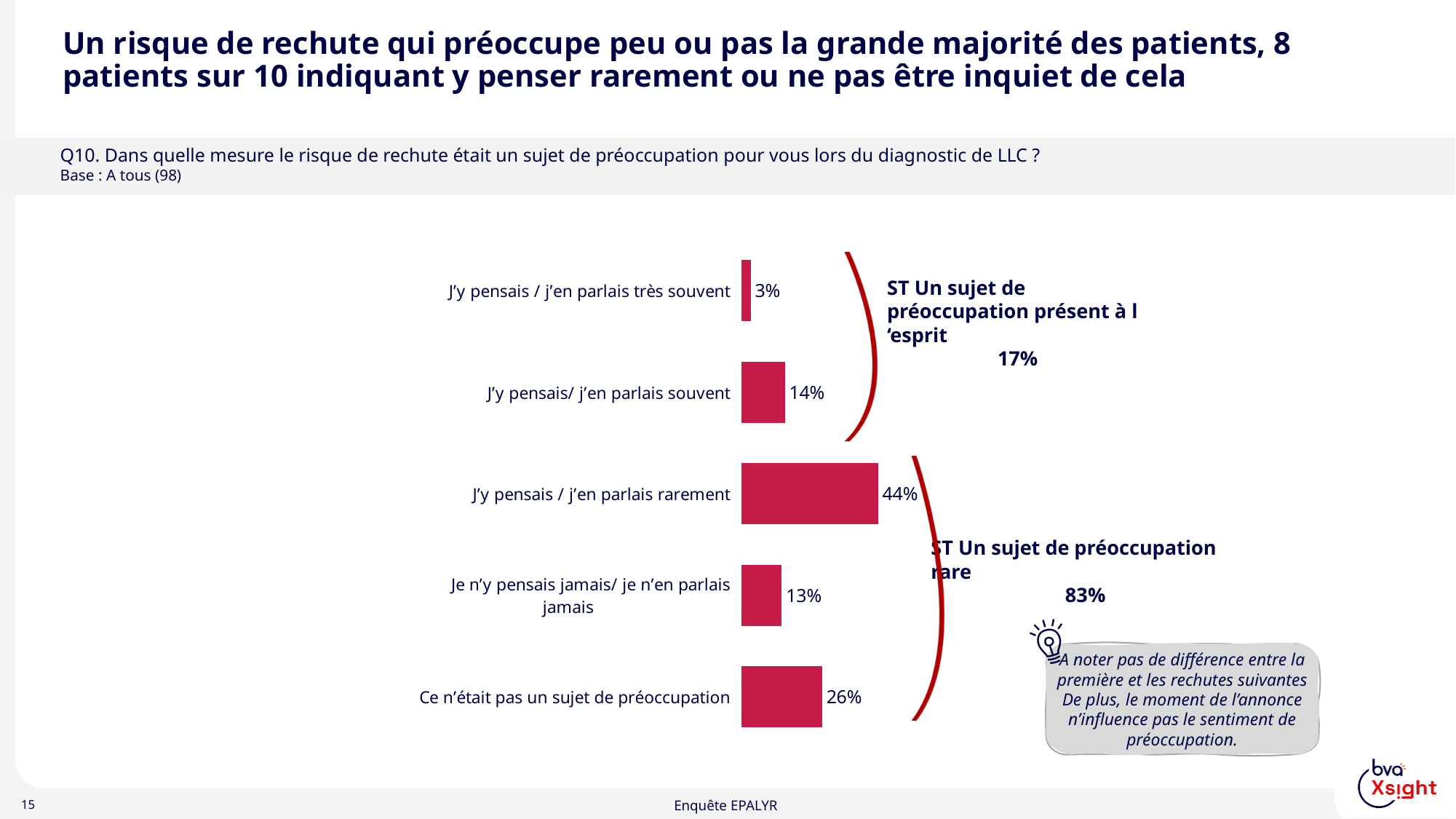
Which is larger: "J'y pensais/ j'en parlais souvent" or "Ce n'était pas un sujet de préoccupation"? Ce n'était pas un sujet de préoccupation What percentage is shown for "Ce n'était pas un sujet de préoccupation"? 26% Which category has the highest value? J'y pensais / j'en parlais rarement What is the value for "Je n'y pensais jamais/ je n'en parlais jamais"? 13% What is the value for "J'y pensais / j'en parlais très souvent"? 3% How many categories are shown in the chart? 5 Which category has the lowest value? J'y pensais / j'en parlais très souvent What is the subtotal shown for "ST Un sujet de préoccupation rare"? 83% What is the base (number of respondents) indicated for the chart? 98 What is the difference between "J'y pensais / j'en parlais rarement" and "Ce n'était pas un sujet de préoccupation"? 18 percentage points What percentage of patients answered "J'y pensais / j'en parlais rarement"? 44% What kind of chart is shown on the slide? Bar chart